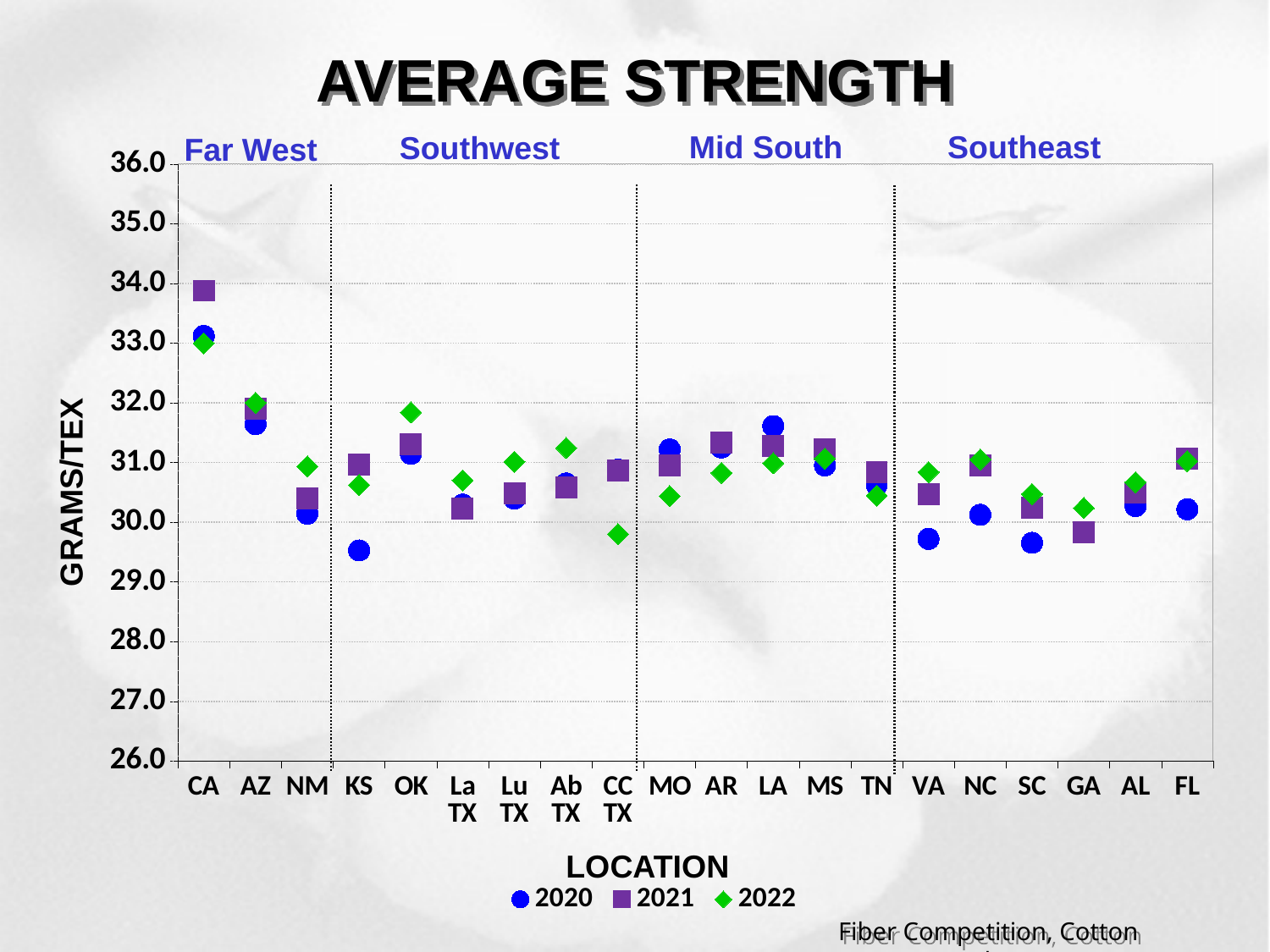
Which location has the highest 2022 value? CA For KS, which is larger: the 2020 value or the 2021 value? 2021 What is the title of the y axis? GRAMS/TEX How many locations are plotted along the x axis? 20 Which location has the lowest 2022 value? CC TX What kind of chart is shown on the slide? Scatter chart Is the 2020 value for KS greater or less than 30.0? less How many series does the legend list? 3 Which location has the highest 2021 value? CA Is the 2022 value for OK greater or less than 31.0? greater Which location has the lowest 2021 value? GA Is the 2021 value for CA greater or less than 33.0? greater